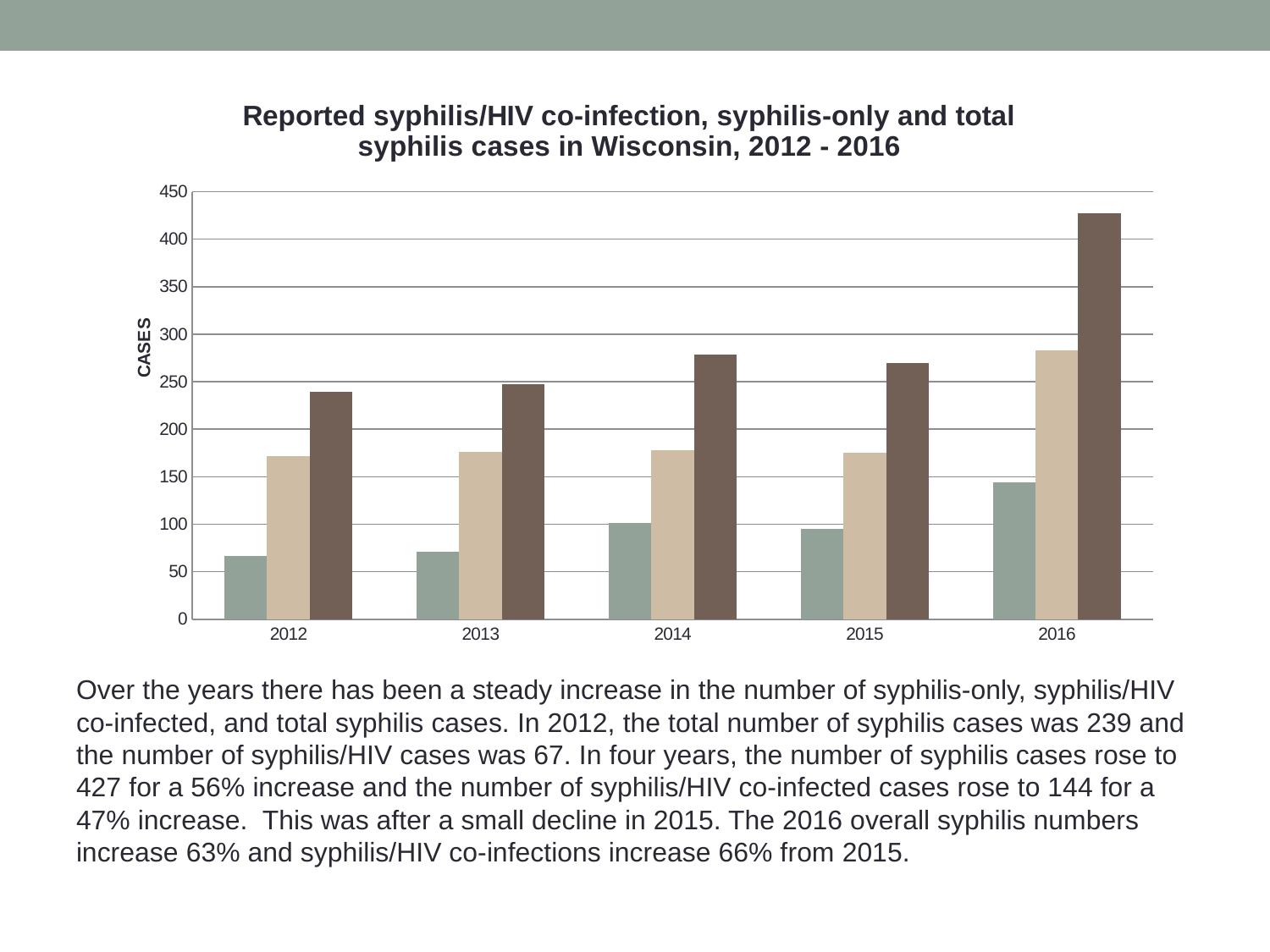
How many years are shown on the x axis of the chart? 5 Is the value of the green bar for 2012 greater or less than 100? less Is the value of the dark brown bar for 2013 greater or less than 200? greater What is the label on the y axis of the chart? CASES Do the dark brown bars rise or fall from 2012 to 2014? rise How many bars are plotted for each year in the chart? 3 What kind of chart is shown on the slide? bar chart Is the value of the tan bar for 2016 greater or less than 250? greater In which year is the green bar the shortest? 2012 In which year is the dark brown bar the tallest? 2016 Which is larger, the tan bar for 2016 or the tan bar for 2012? 2016